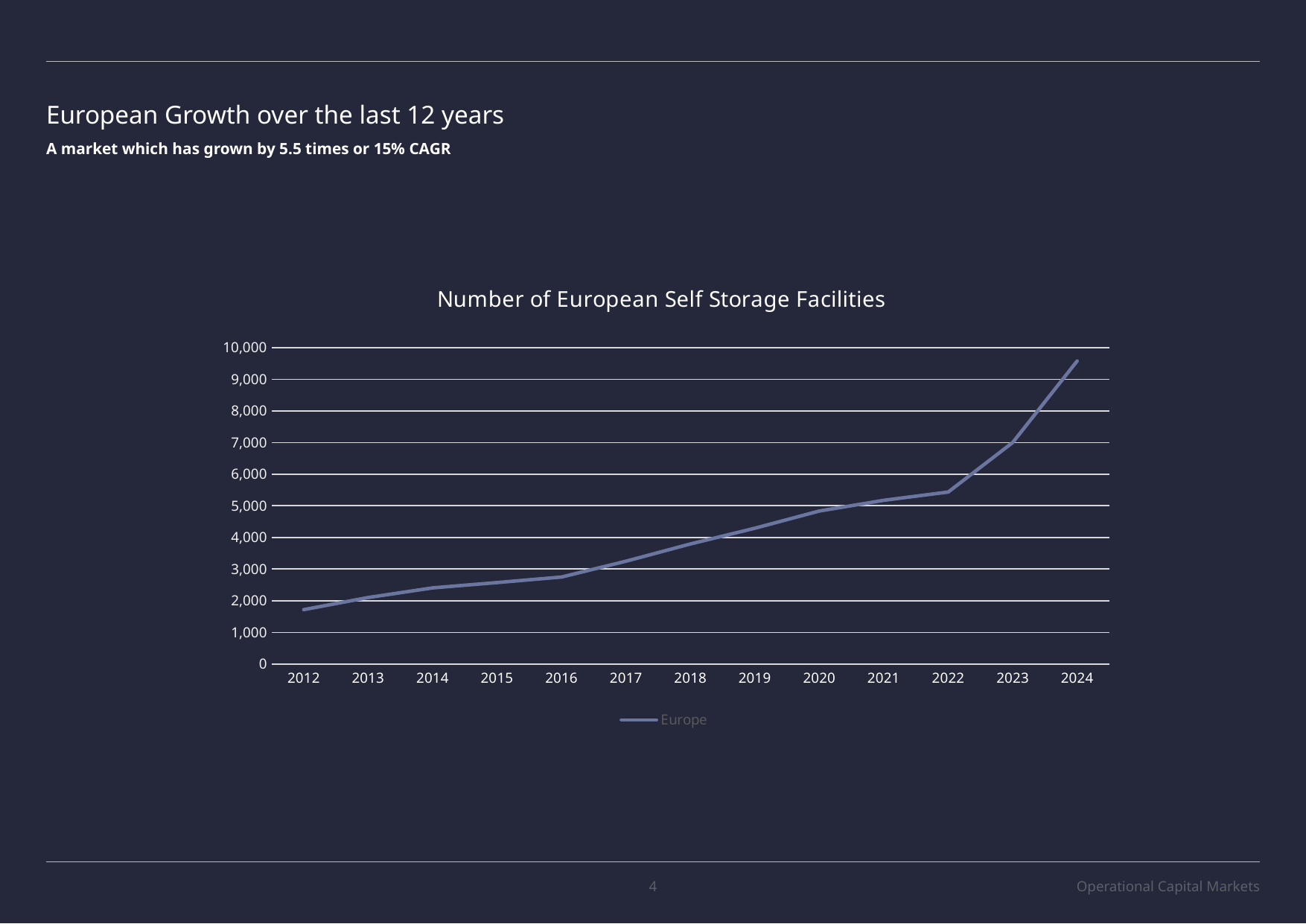
What is the title of the chart? Number of European Self Storage Facilities Is the value for 2024 greater or less than 9,000? greater What kind of chart is shown on the slide? line chart How many years are plotted along the x axis? 13 Is the value for 2022 greater or less than 6,000? less Which year has the highest number of European self storage facilities? 2024 Do the values rise or fall from 2012 to 2024? rise What is the name of the series shown in the legend? Europe Is the value for 2012 greater or less than 2,000? less How many series does the legend list? 1 Which year has the lowest number of European self storage facilities? 2012